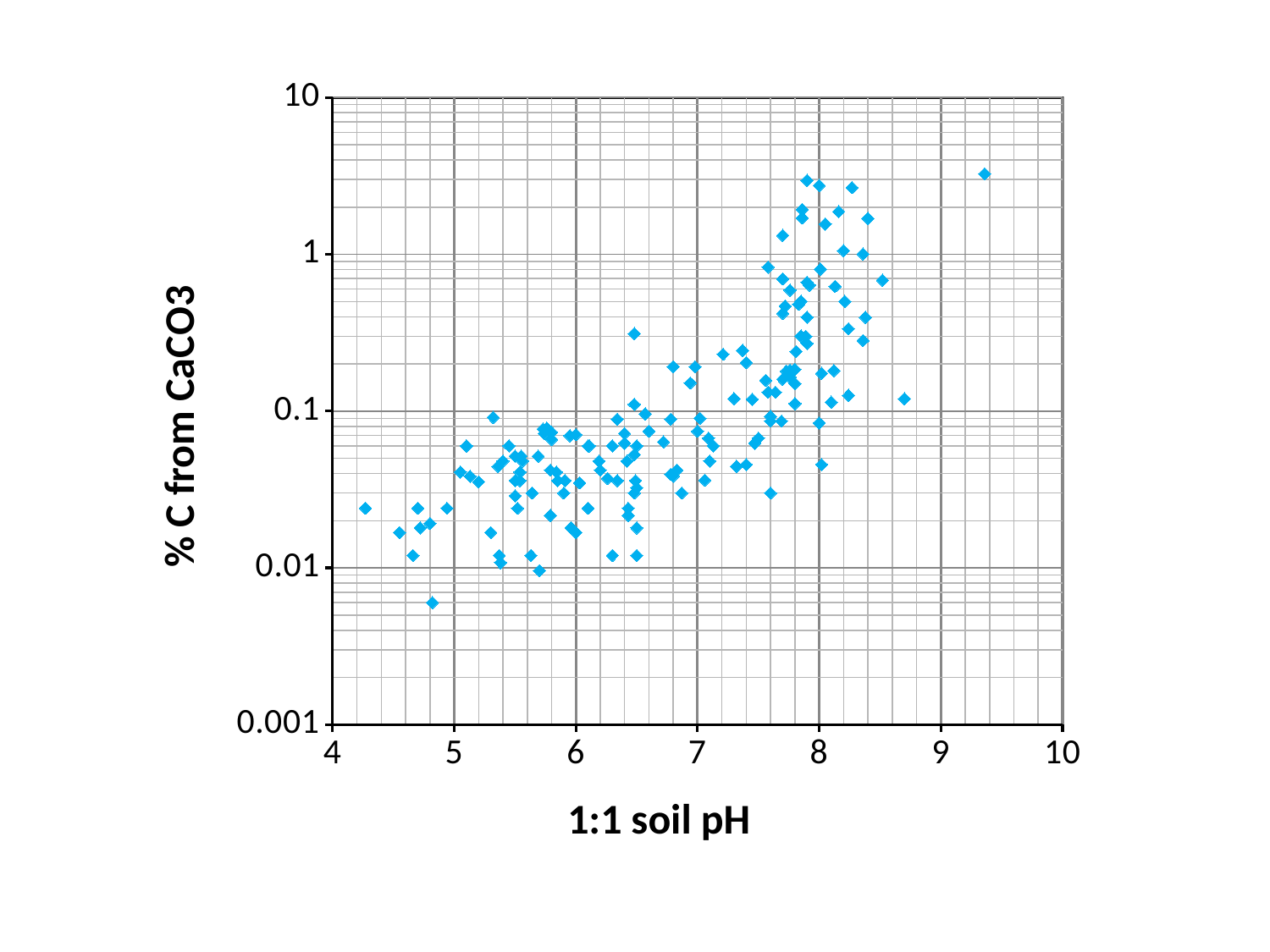
Is the % C from CaCO3 value for the leftmost point (at a soil pH below 4.5) greater or less than 0.1? less What kind of chart is shown on the slide? scatter plot Is the highest plotted % C from CaCO3 value greater or less than 10? less Is the % C from CaCO3 value for the rightmost point (at a soil pH above 9) greater or less than 1? greater Which has the higher % C from CaCO3: the rightmost point (soil pH above 9) or the leftmost point (soil pH below 4.5)? the rightmost point Do the values of % C from CaCO3 generally rise or fall as 1:1 soil pH increases? rise What is the maximum value shown on the y axis? 10 What is the label of the y axis? % C from CaCO3 What is the label of the x axis? 1:1 soil pH